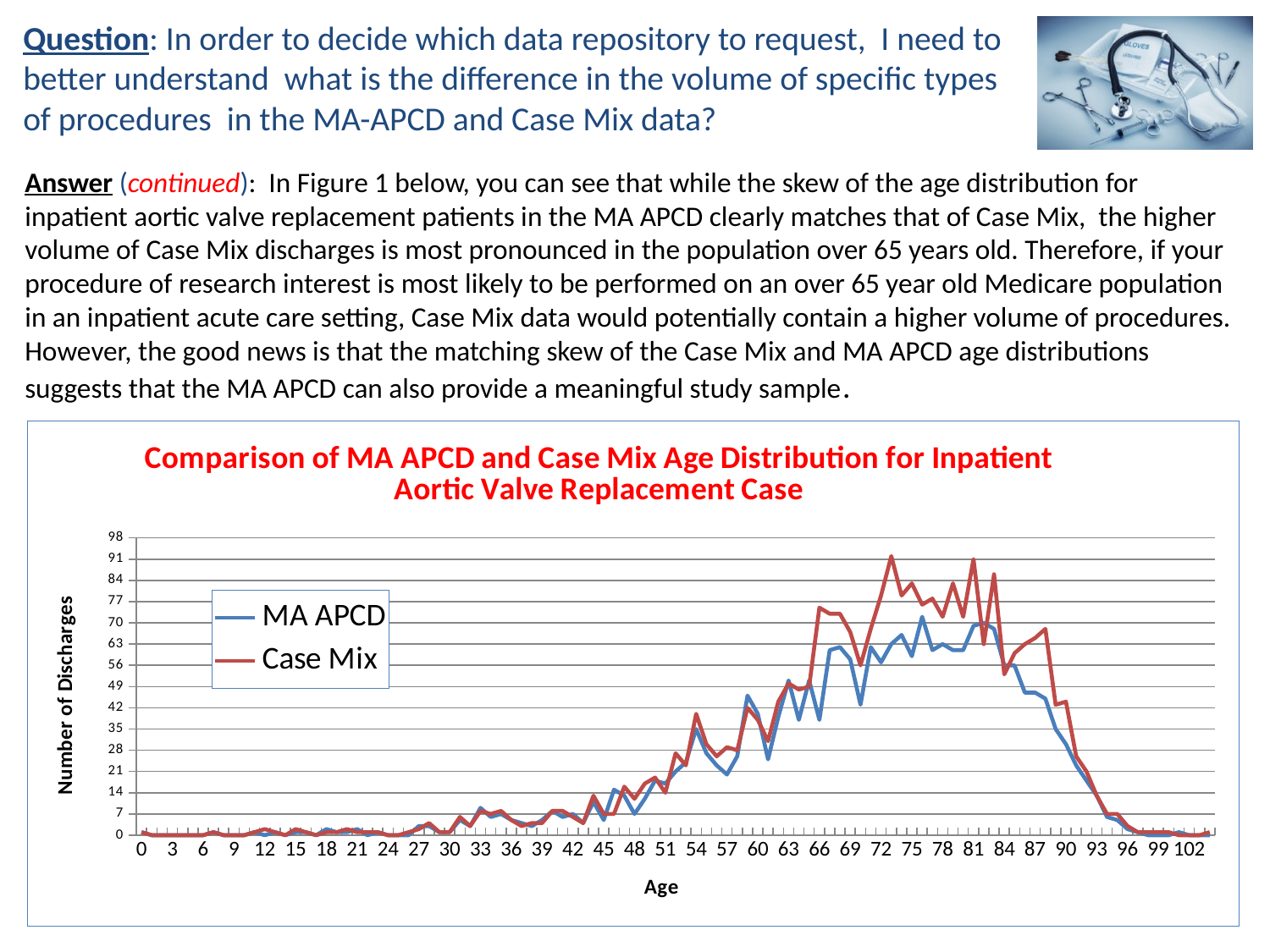
What kind of chart is shown on the slide? Line chart At age 90, which series has more discharges, MA APCD or Case Mix? Case Mix Which series reaches the higher peak number of discharges, MA APCD or Case Mix? Case Mix Do the values for both series generally rise or fall between age 87 and age 102? fall What are the two series named in the chart's legend? MA APCD and Case Mix What is the title of the chart's vertical axis? Number of Discharges Is the peak value of the MA APCD series greater or less than 77? less How many series does the chart's legend list? 2 Is the peak value of the Case Mix series greater or less than 84? greater Do the values for both series generally rise or fall between age 45 and age 70? rise Is the Case Mix value at age 30 greater or less than 7? less At age 66, which series has more discharges, MA APCD or Case Mix? Case Mix